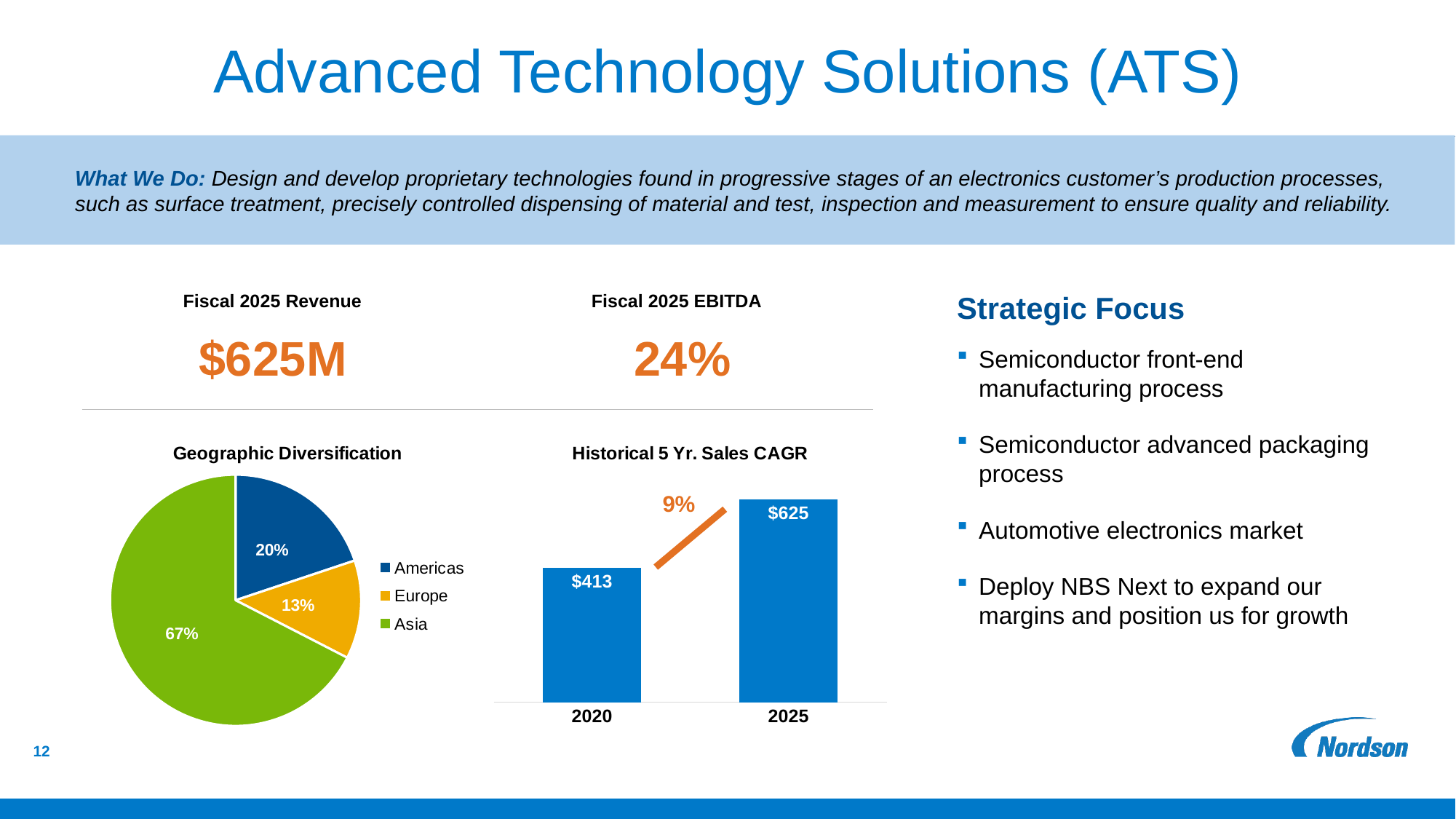
What kind of chart is the Historical 5 Yr. Sales CAGR chart? Bar chart In the Historical 5 Yr. Sales CAGR chart, what is the difference between the 2025 and 2020 values? $212 In the Historical 5 Yr. Sales CAGR chart, do the values rise or fall from 2020 to 2025? Rise In the Geographic Diversification pie chart, which region has the largest share? Asia In the Geographic Diversification pie chart, which region has the smallest share? Europe What kind of chart is the Geographic Diversification chart? Pie chart In the Historical 5 Yr. Sales CAGR chart, what is the value for 2025? $625 In the Historical 5 Yr. Sales CAGR chart, what is the value for 2020? $413 In the Geographic Diversification pie chart, what share does Americas hold? 20% In the Geographic Diversification pie chart, how many regions are shown in the legend? 3 In the Geographic Diversification pie chart, what share does Europe hold? 13% In the Geographic Diversification pie chart, what share does Asia hold? 67%